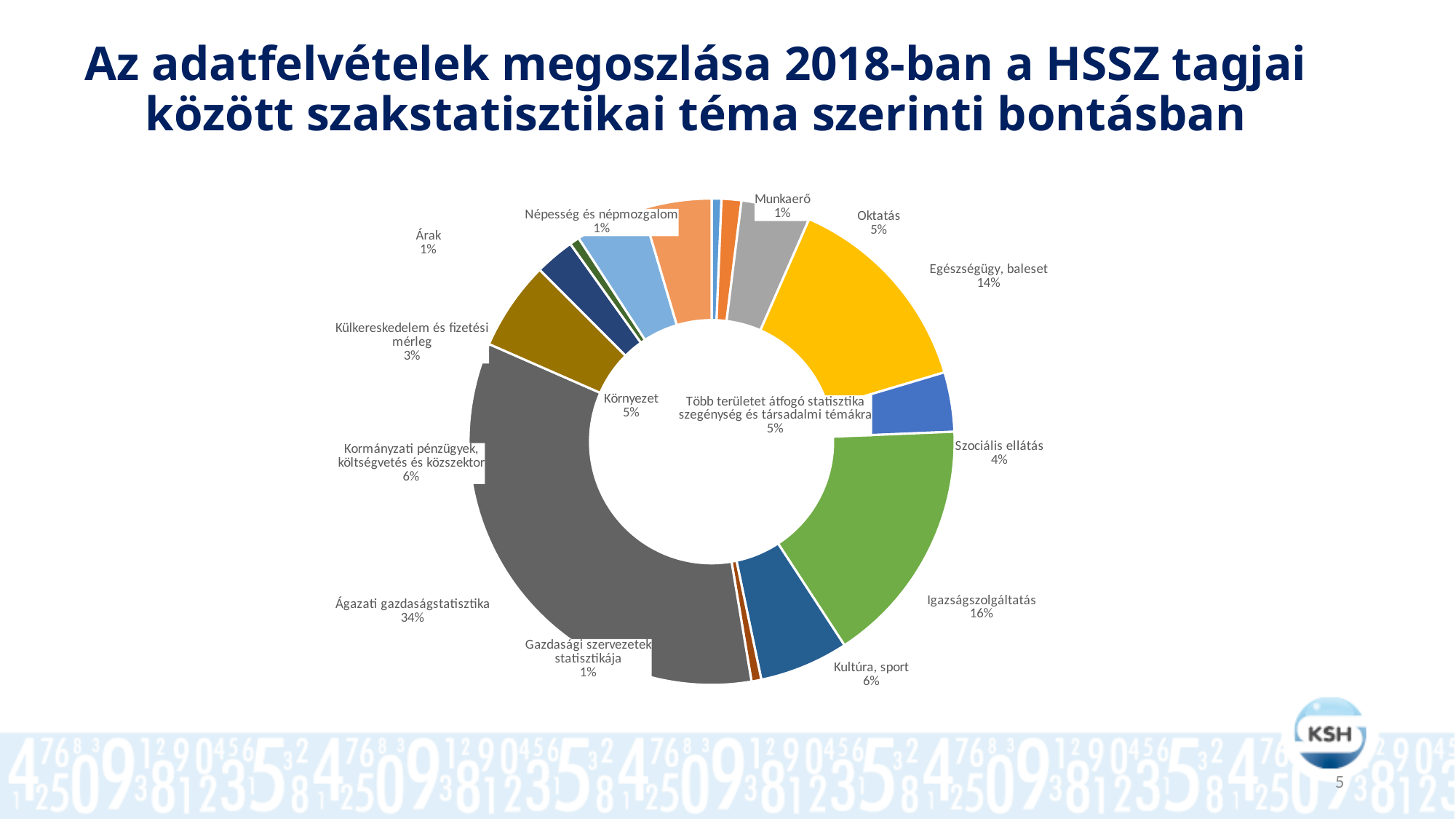
Which has a larger share, Kultúra, sport or Oktatás? Kultúra, sport What percentage is shown for Egészségügy, baleset? 14% What year does the chart title refer to? 2018 What kind of chart is shown on the slide? Doughnut (pie) chart What is the difference in percentage points between Ágazati gazdaságstatisztika and Igazságszolgáltatás? 18 percentage points Which has a larger share, Egészségügy, baleset or Kormányzati pénzügyek, költségvetés és közszektor? Egészségügy, baleset What percentage is shown for Külkereskedelem és fizetési mérleg? 3% What percentage is shown for Igazságszolgáltatás? 16% What percentage is shown for Szociális ellátás? 4% What is the difference in percentage points between Igazságszolgáltatás and Egészségügy, baleset? 2 percentage points What share of the data collections does Ágazati gazdaságstatisztika account for? 34% Which category has the largest share of the chart? Ágazati gazdaságstatisztika